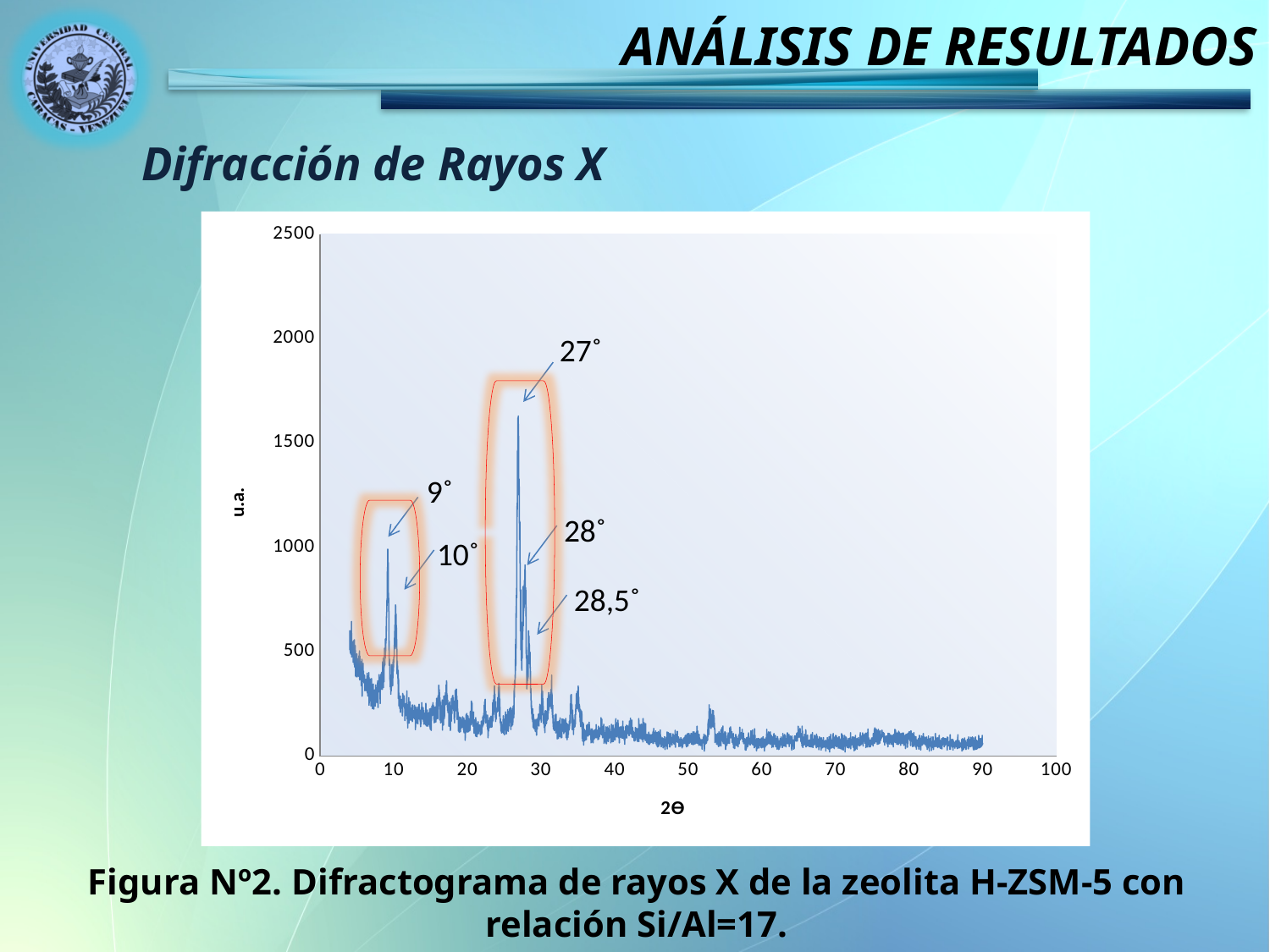
What is the maximum value shown on the y axis of the chart? 2500 Is the intensity of the peak at 27˚ greater or less than 1500? greater Which annotated peak angle has the highest intensity in the diffractogram? 27˚ Is the intensity of the peak at 28,5˚ greater or less than 1000? less Is the intensity of the peak at 9˚ greater or less than 1500? less What is the label of the y axis of the chart? u.a. Which peak has a higher intensity, the one at 27˚ or the one at 28˚? 27˚ What is the label of the x axis of the chart? 2Θ Overall, does the intensity rise or fall as 2Θ increases from 30 to 90? fall How many peak angles are annotated with labels on the chart? 5 Which peak has a higher intensity, the one at 9˚ or the one at 10˚? 9˚ What kind of chart is shown on the slide? line chart